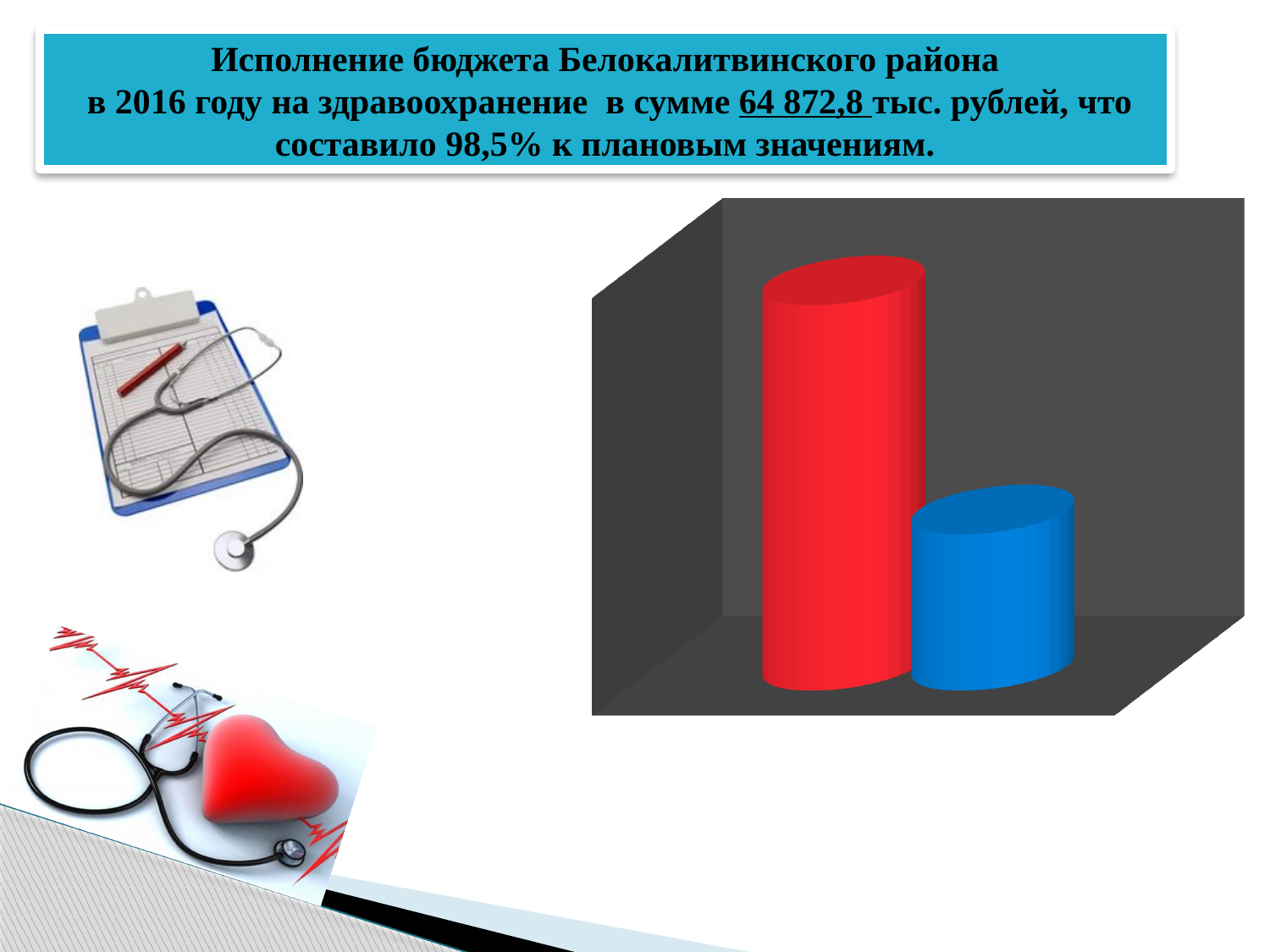
Which bar in the chart is the shortest? the blue bar What colours are the two bars in the chart? red and blue Does the chart on the right display a legend? No How many bars does the chart on the right show? 2 Which bar in the chart is the tallest? the red bar Which bar is taller, the red one or the blue one? the red one What kind of chart is shown on the right side of the slide? bar chart